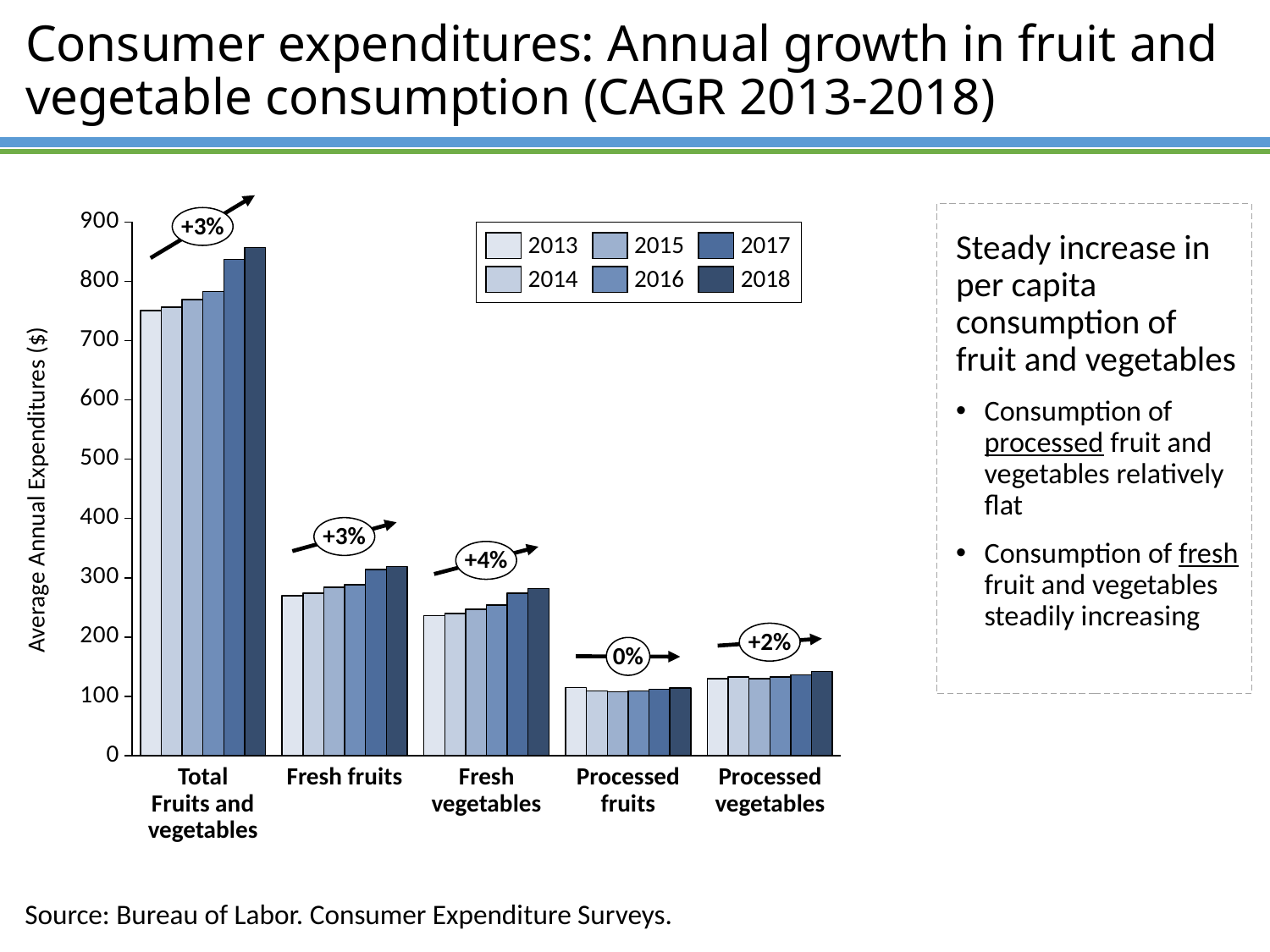
Is the 2018 value for Processed vegetables greater or less than 200? less Which category has the lowest bars in the chart? Processed fruits In 2018, which is larger: the value for Fresh fruits or the value for Fresh vegetables? Fresh fruits How many categories are shown along the x axis of the chart? 5 What kind of chart is shown on the slide? Bar chart Is the 2018 value for Total Fruits and vegetables greater or less than 800? greater Do the values for Total Fruits and vegetables rise or fall from 2013 to 2018? Rise What CAGR is annotated above the Fresh vegetables bars? +4% Is the 2013 value for Fresh fruits greater or less than 300? less What is the label on the y axis of the chart? Average Annual Expenditures ($) Which category has the highest bars in the chart? Total Fruits and vegetables How many series does the chart's legend list? 6